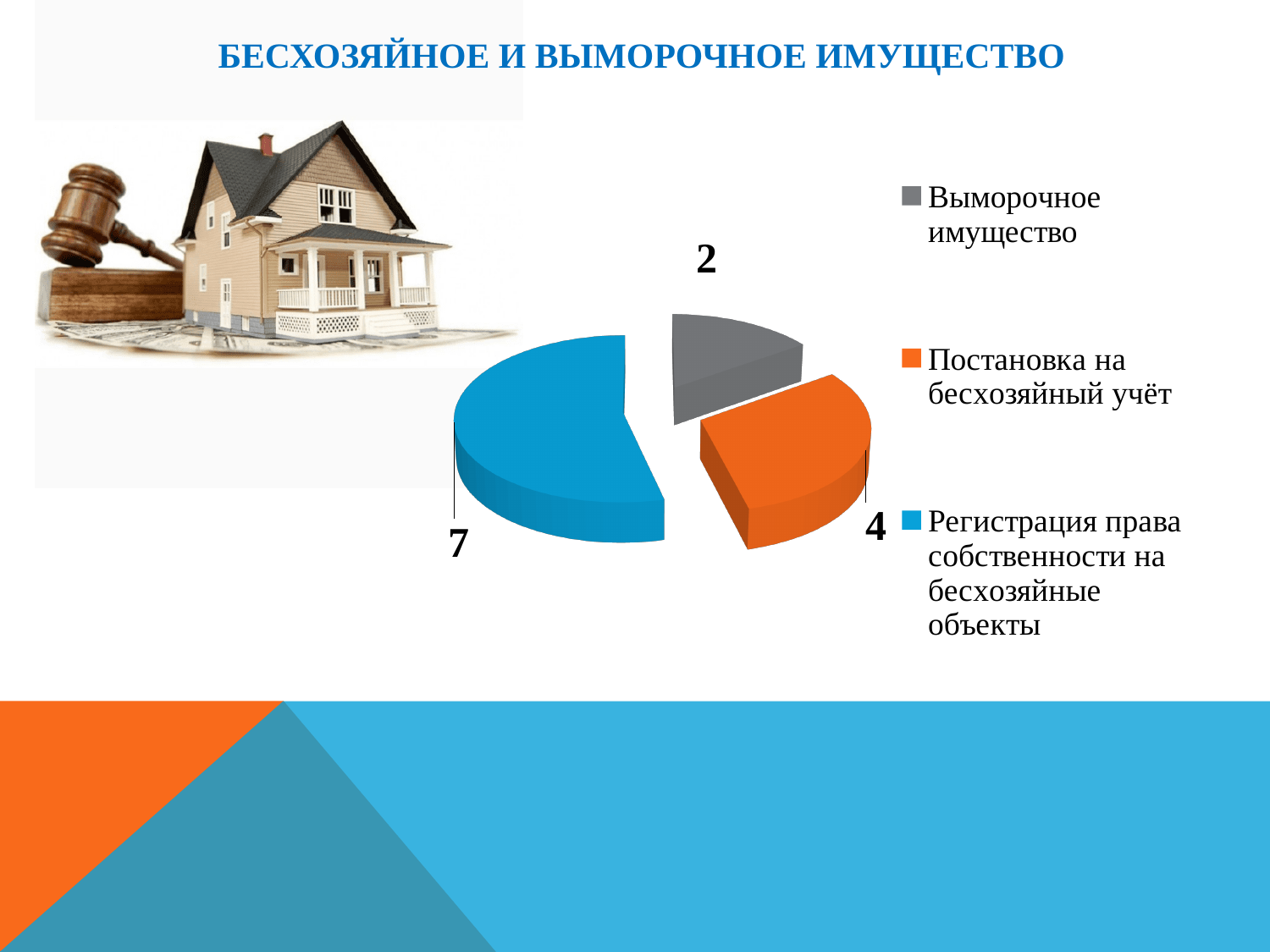
How many slices does the pie chart have? 3 Which is larger: the value for Постановка на бесхозяйный учёт or the value for Выморочное имущество? Постановка на бесхозяйный учёт What is the value for Регистрация права собственности на бесхозяйные объекты? 7 What is the value for Выморочное имущество? 2 What is the difference between the values for Регистрация права собственности на бесхозяйные объекты and Постановка на бесхозяйный учёт? 3 What is the difference between the values for Постановка на бесхозяйный учёт and Выморочное имущество? 2 Which category has the smallest slice of the pie? Выморочное имущество What kind of chart is shown on the slide? Pie chart What is the total of all the values shown in the pie chart? 13 Which category has the largest slice of the pie? Регистрация права собственности на бесхозяйные объекты What is the value for Постановка на бесхозяйный учёт? 4 What colour is the slice for Постановка на бесхозяйный учёт? Orange